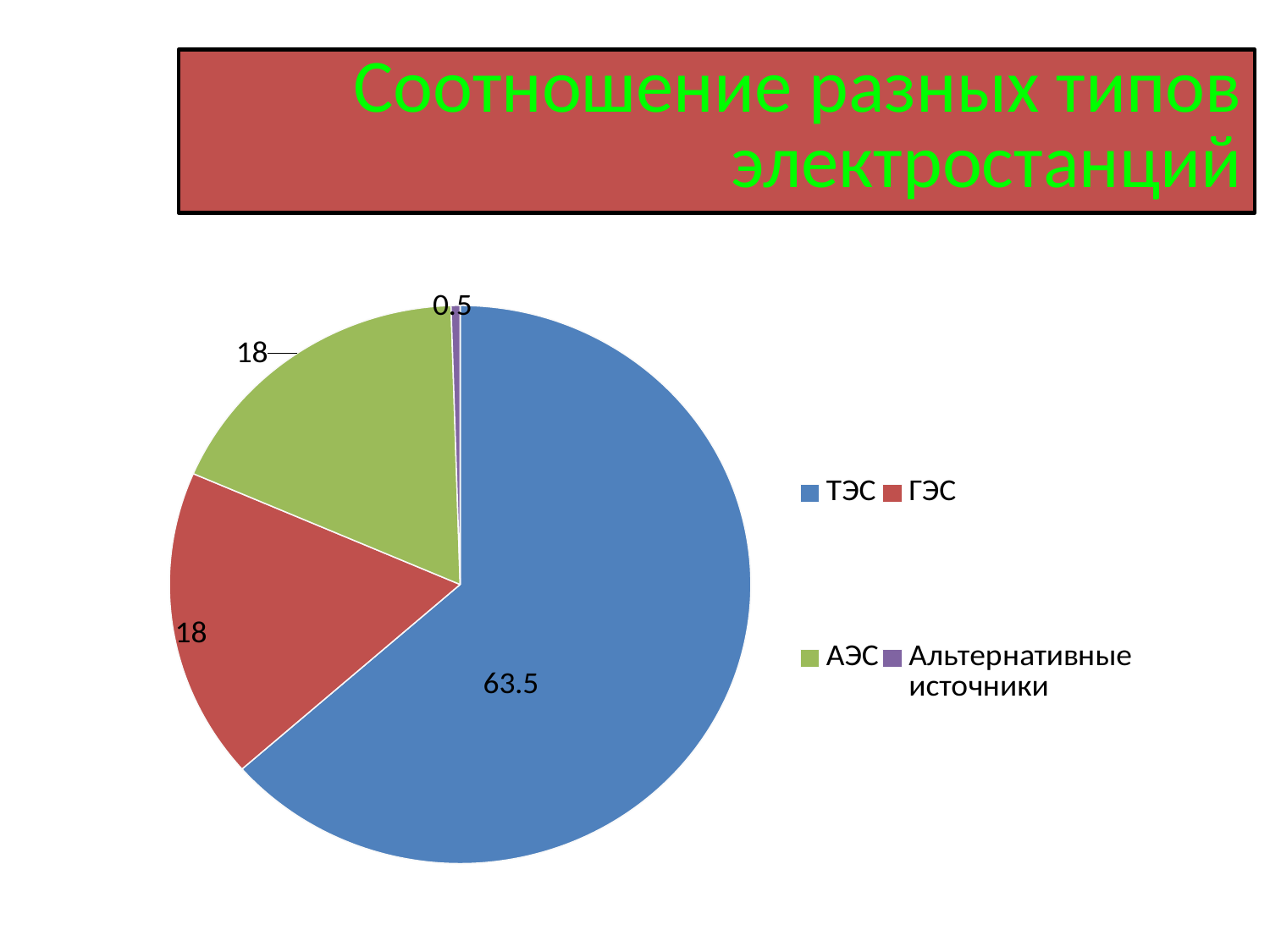
Which category has the largest slice of the pie chart? ТЭС Which category has the smallest slice of the pie chart? Альтернативные источники What value is shown for ГЭС on the pie chart? 18 Which is larger, the value for ТЭС or the value for АЭС? ТЭС What is the difference between the values for АЭС and Альтернативные источники? 17.5 How many categories are shown in the pie chart? 4 What value is shown for Альтернативные источники on the pie chart? 0.5 What is the difference between the values for ТЭС and ГЭС? 45.5 What kind of chart is shown on the slide? Pie chart What value is shown for ТЭС on the pie chart? 63.5 What is the title of the chart on the slide? Соотношение разных типов электростанций What value is shown for АЭС on the pie chart? 18